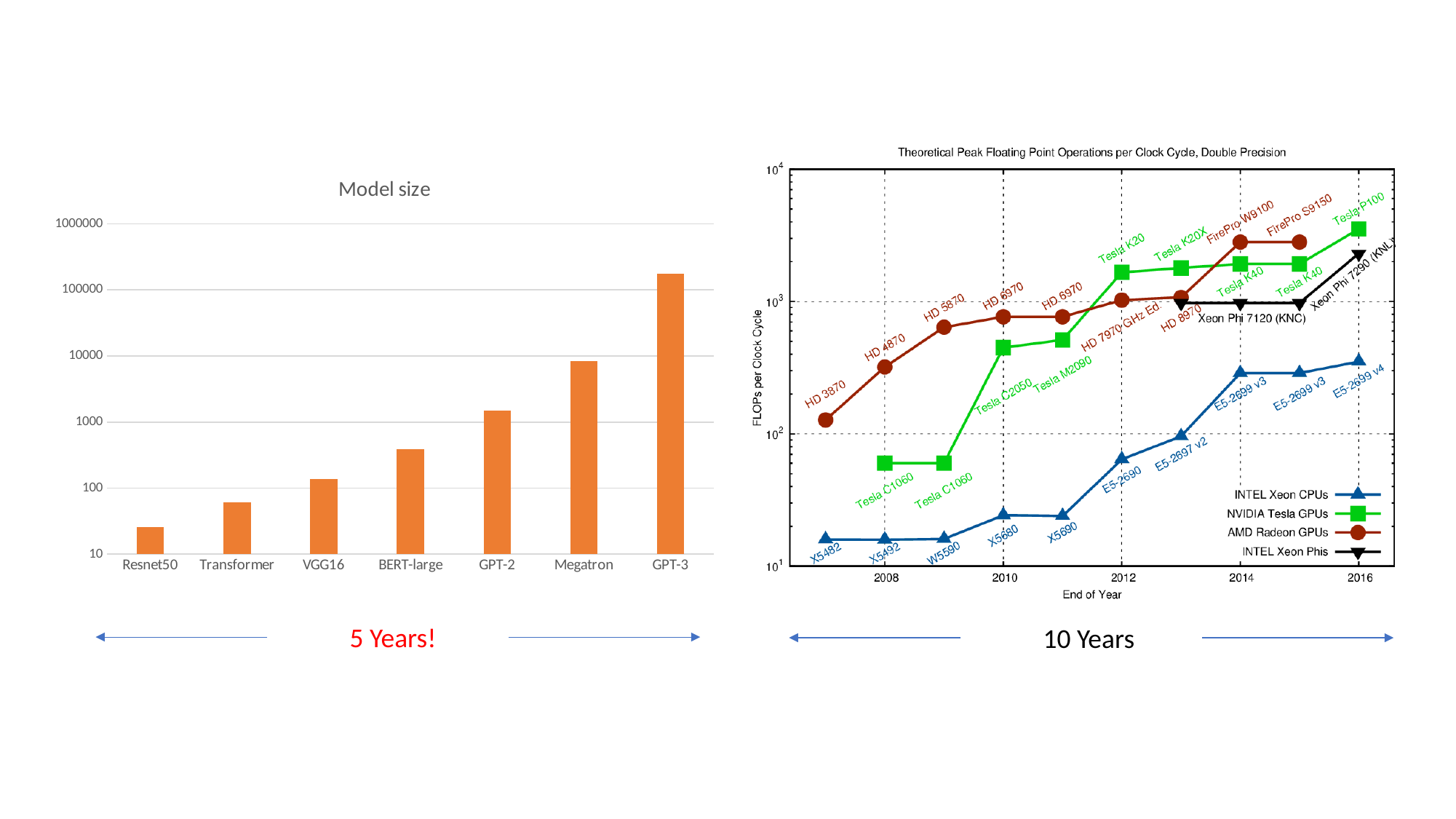
In the 'Model size' chart, which model has the smallest bar? Resnet50 What kind of chart is the 'Model size' chart on the left? bar chart In the 'Model size' chart, is the value for Transformer greater or less than 100? less How many models are shown on the x axis of the 'Model size' chart? 7 In the right-hand chart, is the value for INTEL Xeon CPUs at the end of 2016 greater or less than 1000? less In the 'Model size' chart, do the bars rise or fall from Resnet50 to GPT-3? rise In the 'Model size' chart, is the value for GPT-3 greater or less than 100000? greater In the 'Model size' chart, which model has the largest bar? GPT-3 In the right-hand chart, which series has the highest value at the end of 2016? NVIDIA Tesla GPUs What kind of chart is the 'Theoretical Peak Floating Point Operations per Clock Cycle, Double Precision' chart on the right? line chart How many series does the legend of the right-hand chart list? 4